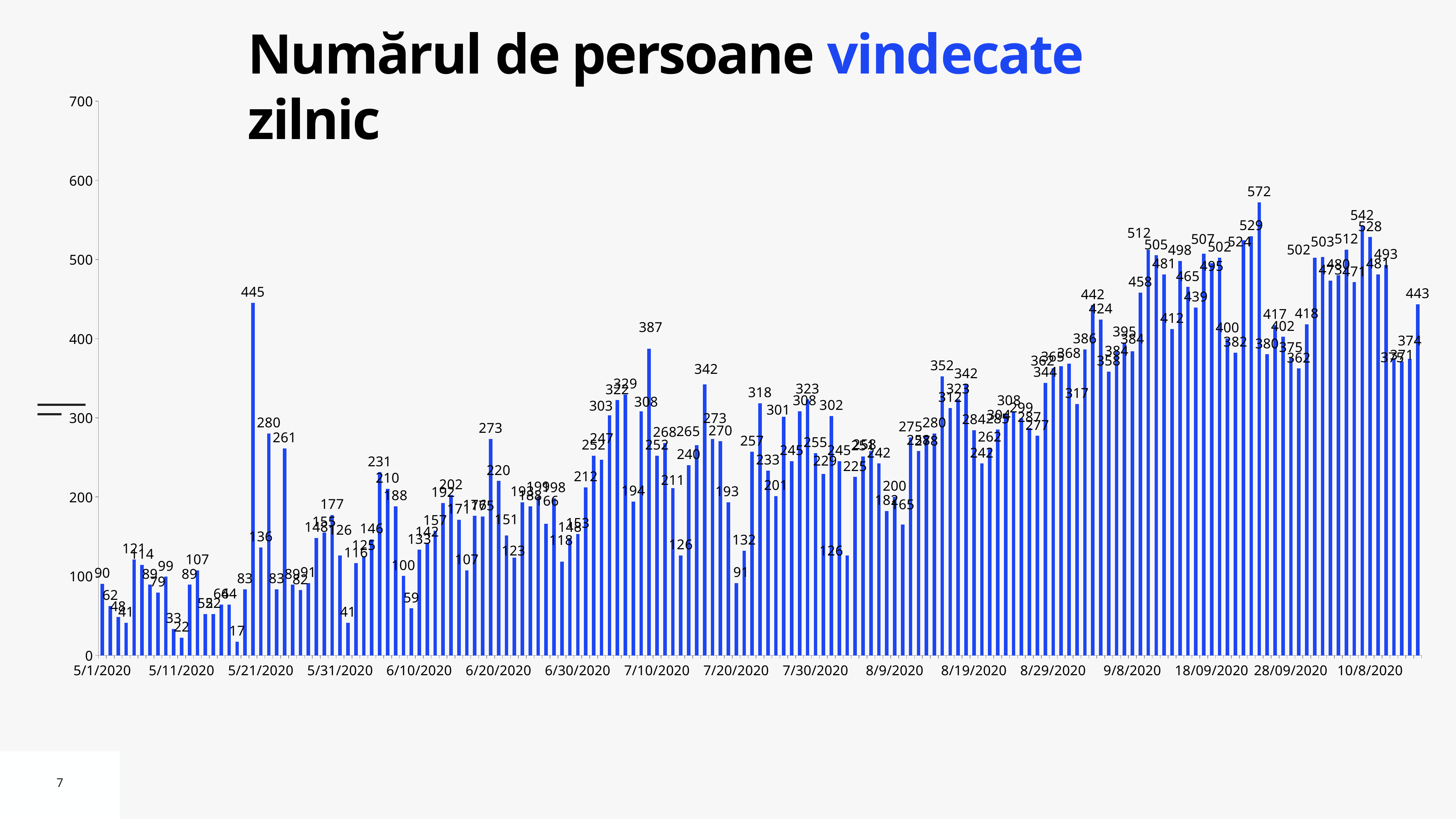
What is the difference between the highest value (572) and the lowest value (17) on the chart? 555 What is the lowest daily value shown on the chart? 17 What is the value for 5/1/2020, the first bar on the chart? 90 What is the highest daily value shown on the chart? 572 Which is larger: the tallest bar in May (445) or the tallest bar in July (387)? 445 What is the maximum value shown on the vertical axis? 700 Do the values generally rise or fall from May to October along the x axis? rise What is the title of the chart? Numărul de persoane vindecate zilnic What kind of chart is shown on the slide? bar chart Is the value for 5/1/2020 greater or less than 100? less What is the difference between the tallest bar in May (445) and the tallest bar in July (387)? 58 Is the highest value on the chart greater or less than 500? greater